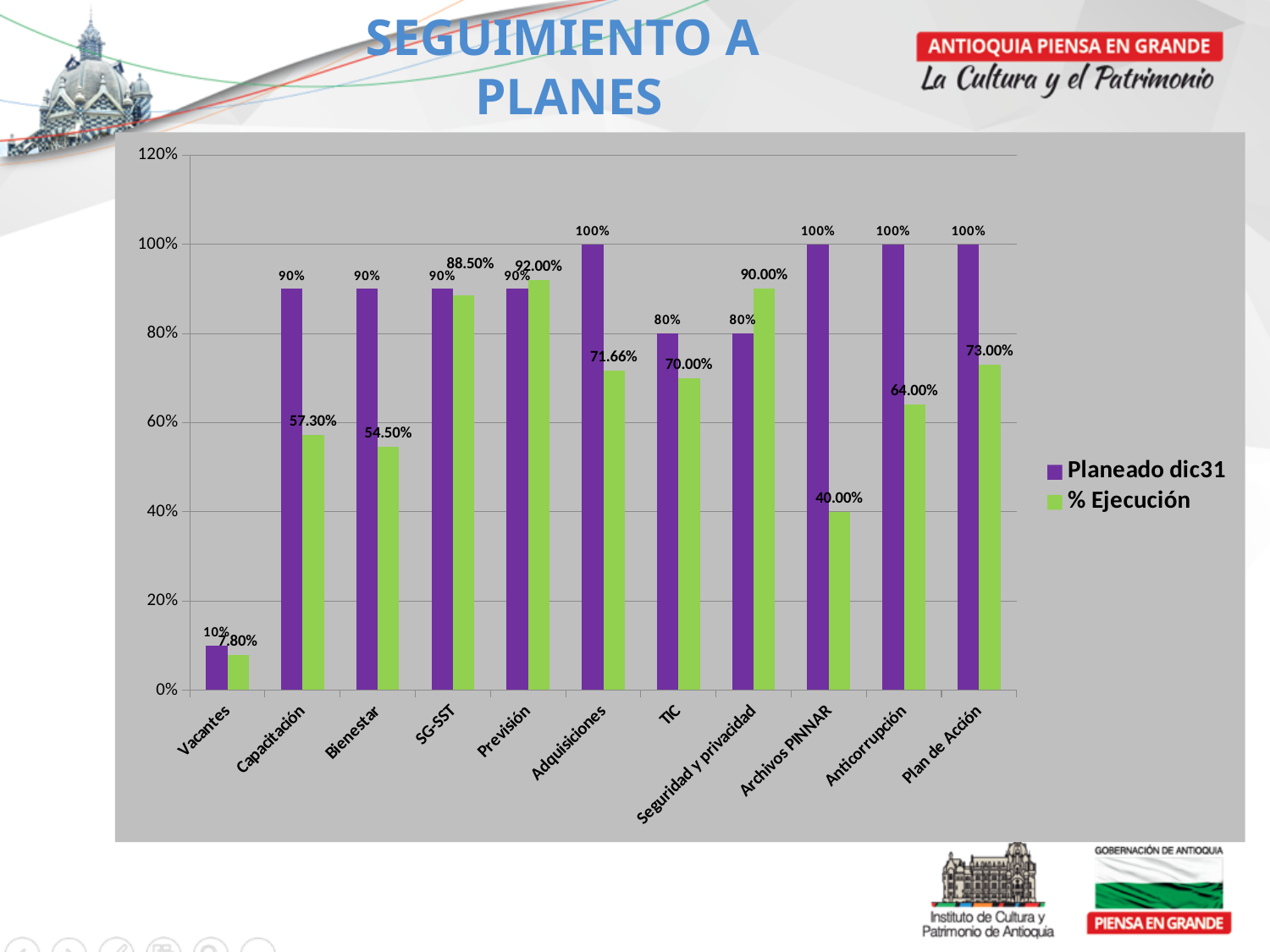
Which category has the highest % Ejecución value? Previsión What kind of chart is shown on the slide? Bar chart Which is larger for Seguridad y privacidad: the Planeado dic31 value or the % Ejecución value? % Ejecución What is the Planeado dic31 value for TIC? 80% How many categories are shown on the x axis? 11 What is the % Ejecución value for Archivos PINNAR? 40.00% What is the difference between the Planeado dic31 and % Ejecución values for Anticorrupción? 36% How many series does the legend list? 2 What is the % Ejecución value for Adquisiciones? 71.66% Which category has the lowest % Ejecución value? Vacantes Which colour represents the % Ejecución series? Green What is the % Ejecución value for Capacitación? 57.30%